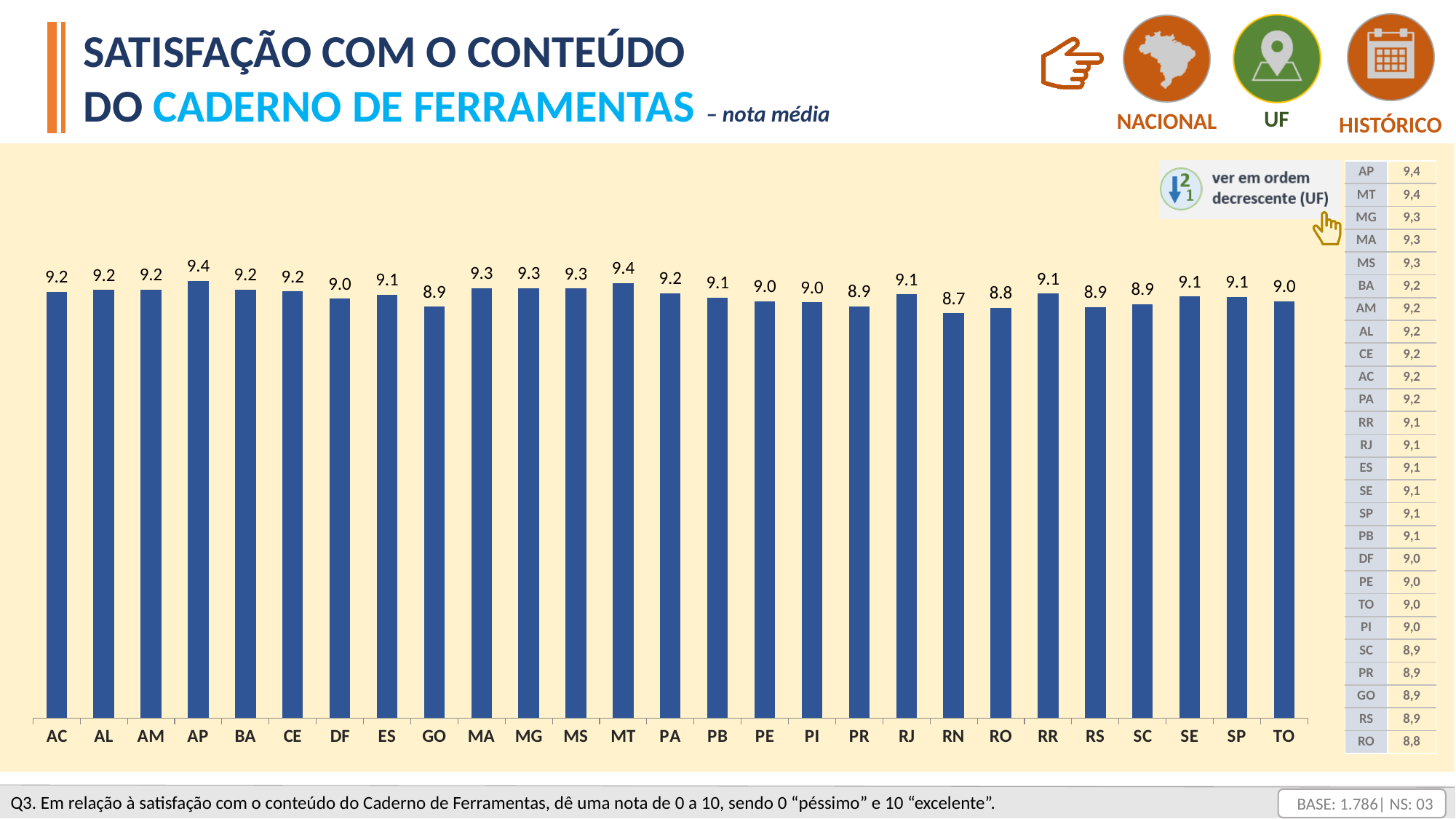
What is the value for AP? 9.4 Which state has the lowest value? RN What is the value for RN? 8.7 Which is larger, the value for MA or the value for PR? MA Which is larger, the value for RO or the value for SE? SE What kind of chart is shown on the slide? bar chart What is the value for MG? 9.3 How many states (bars) are shown in the chart? 27 What is the value for GO? 8.9 What is the difference between the values for AC and RO? 0.4 What is the value for TO? 9.0 What is the difference between the values for MT and RN? 0.7